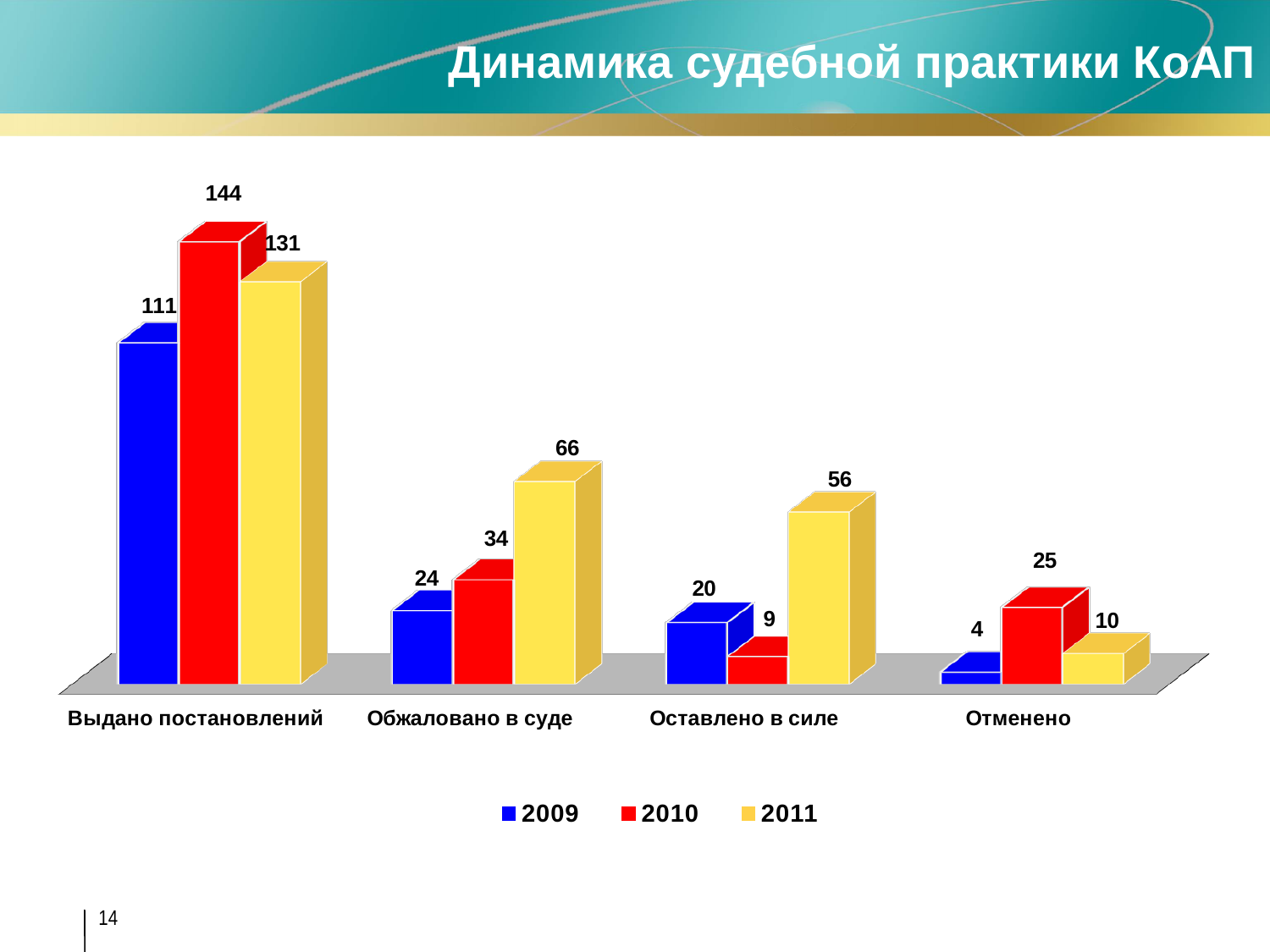
What is the value for 2011 in the category "Оставлено в силе"? 56 Which is larger: the 2010 value for "Отменено" or the 2011 value for "Отменено"? 2010 What is the value for 2009 in the category "Отменено"? 4 What kind of chart is shown on the slide? bar chart How many series does the legend list? 3 Which year has the lowest value in the category "Оставлено в силе"? 2010 Which year has the highest value in the category "Обжаловано в суде"? 2011 How many categories are shown on the x axis? 4 What is the difference between the 2011 and 2010 values for "Обжаловано в суде"? 32 What is the value for 2010 in the category "Выдано постановлений"? 144 What is the title of the slide? Динамика судебной практики КоАП What is the difference between the 2010 and 2009 values for "Выдано постановлений"? 33